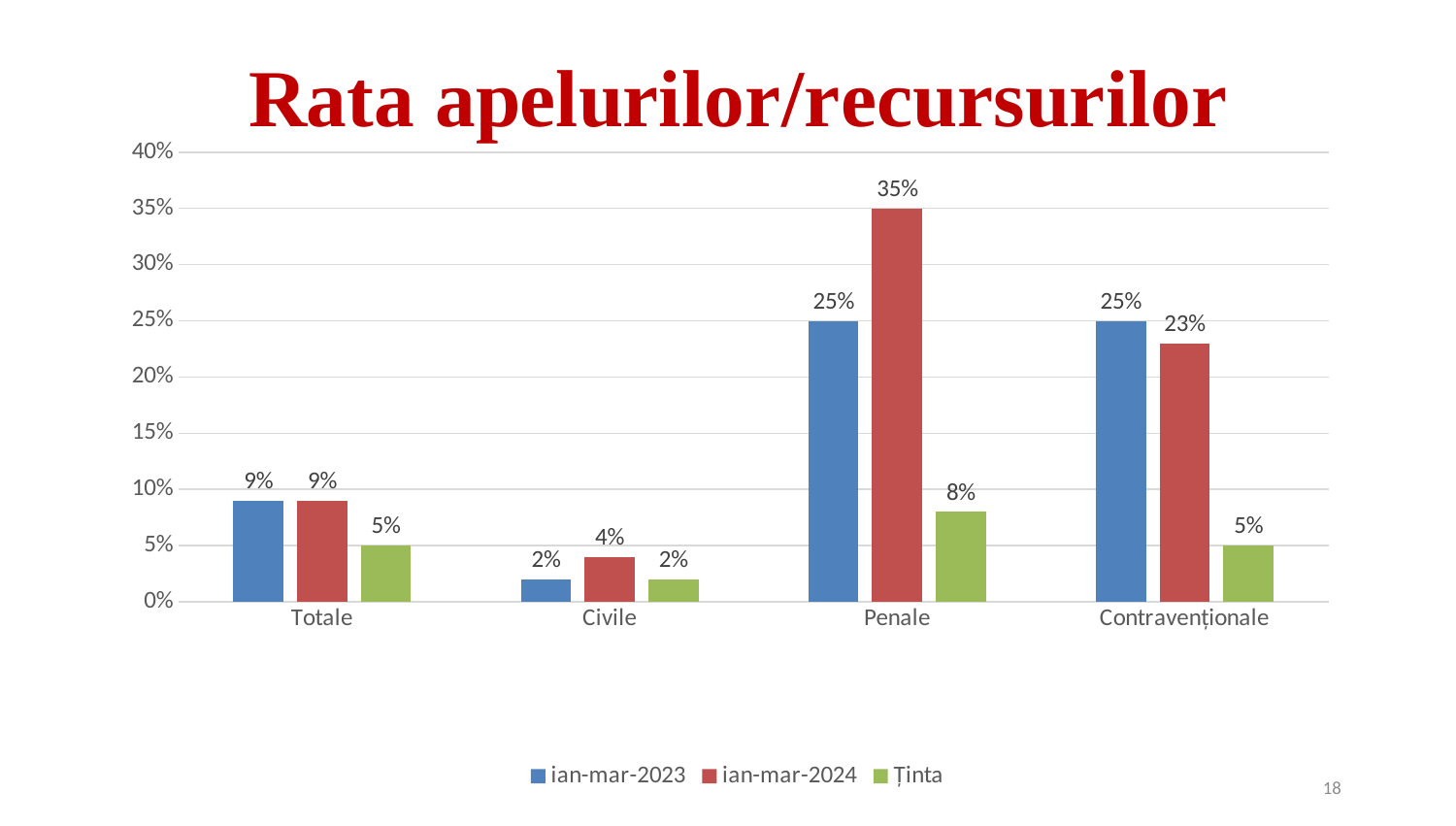
What kind of chart is shown on the slide? bar chart What is the ian-mar-2024 value for Penale? 35% What is the Ținta value for Contravenționale? 5% What is the difference between the ian-mar-2024 and ian-mar-2023 values for Penale? 10% Is the ian-mar-2024 value for Penale greater or less than 30%? greater Which category has the lowest Ținta value? Civile Which category has the highest ian-mar-2024 value? Penale For Contravenționale, which is larger: the ian-mar-2023 value or the ian-mar-2024 value? ian-mar-2023 What is the title of the chart? Rata apelurilor/recursurilor How many categories are shown on the x axis? 4 What is the ian-mar-2023 value for Civile? 2% How many series does the legend list? 3